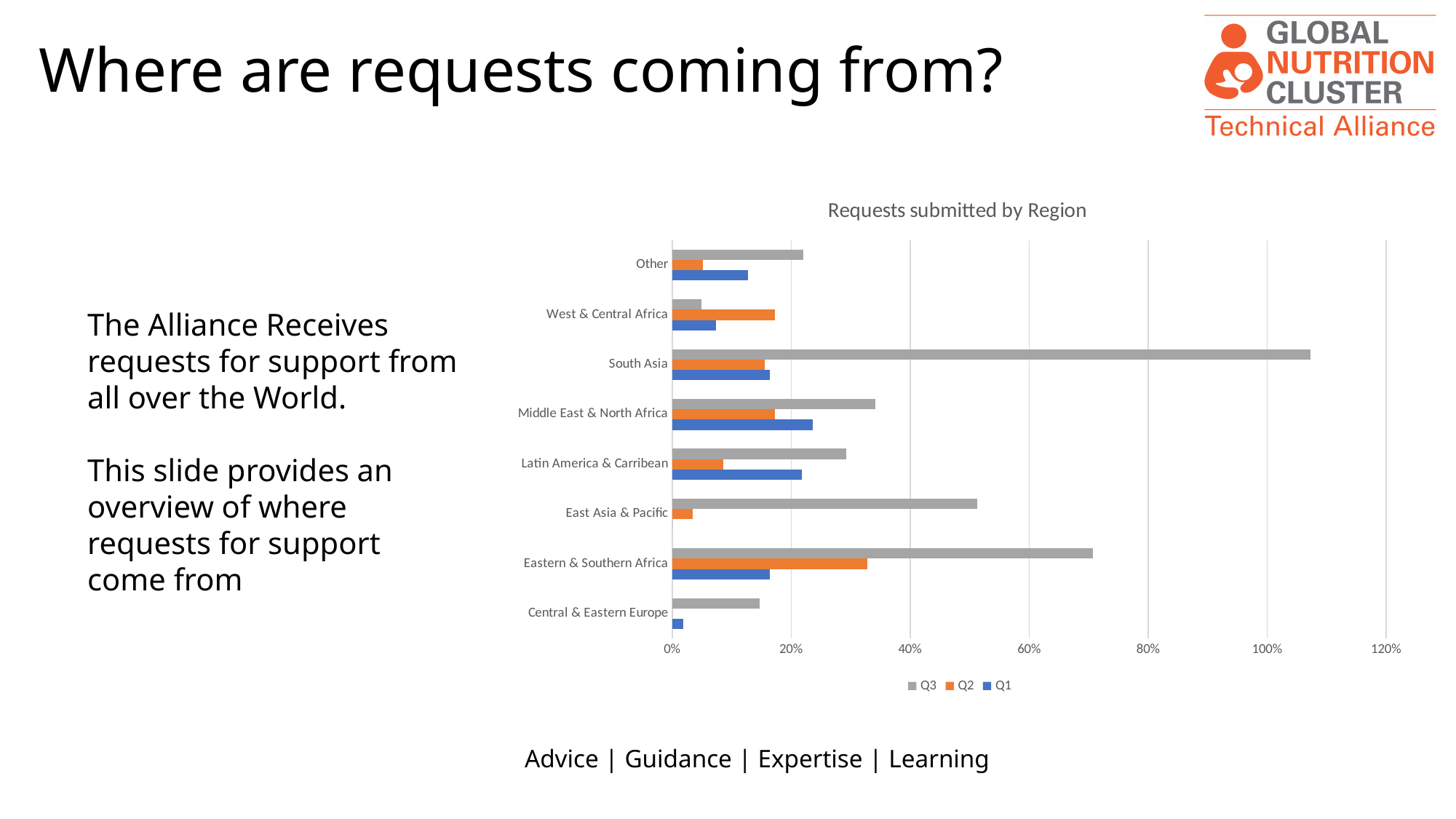
Which region has the highest Q3 value? South Asia How many regions are shown on the chart? 8 Which region has the lowest Q3 value? West & Central Africa Is the Q3 value for Eastern & Southern Africa greater or less than 60%? greater For East Asia & Pacific, which is larger: the Q3 value or the Q2 value? Q3 What kind of chart is shown on the slide? Bar chart Which region has the highest Q2 value? Eastern & Southern Africa For West & Central Africa, which is larger: the Q2 value or the Q3 value? Q2 Is the Q3 value for South Asia greater or less than 100%? greater What is the title of the chart? Requests submitted by Region Is the Q3 value for East Asia & Pacific greater or less than 40%? greater How many series does the legend of the chart list? 3